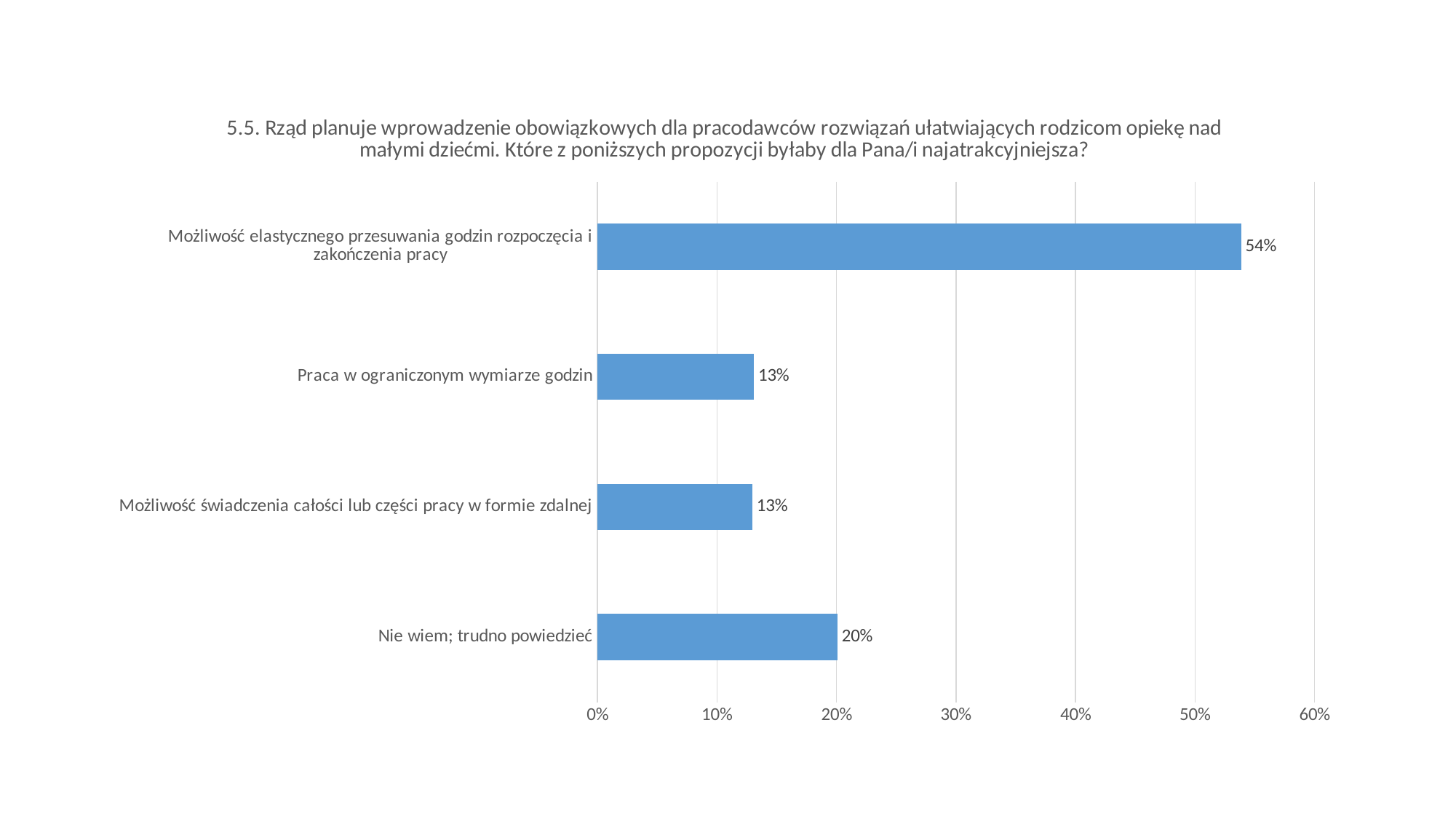
What is the value for "Nie wiem; trudno powiedzieć"? 20% What is the value for "Możliwość elastycznego przesuwania godzin rozpoczęcia i zakończenia pracy"? 54% What is the value for "Praca w ograniczonym wymiarze godzin"? 13% Which is larger: the value for "Nie wiem; trudno powiedzieć" or the value for "Praca w ograniczonym wymiarze godzin"? Nie wiem; trudno powiedzieć Is the value for "Możliwość elastycznego przesuwania godzin rozpoczęcia i zakończenia pracy" greater or less than 50%? greater What kind of chart is shown on the slide? Bar chart What is the difference between the values for "Nie wiem; trudno powiedzieć" and "Praca w ograniczonym wymiarze godzin"? 7% What is the highest value shown on the horizontal axis? 60% Which category has the highest value? Możliwość elastycznego przesuwania godzin rozpoczęcia i zakończenia pracy What is the difference between the values for "Możliwość elastycznego przesuwania godzin rozpoczęcia i zakończenia pracy" and "Nie wiem; trudno powiedzieć"? 34% What is the value for "Możliwość świadczenia całości lub części pracy w formie zdalnej"? 13% How many categories are shown in the chart? 4